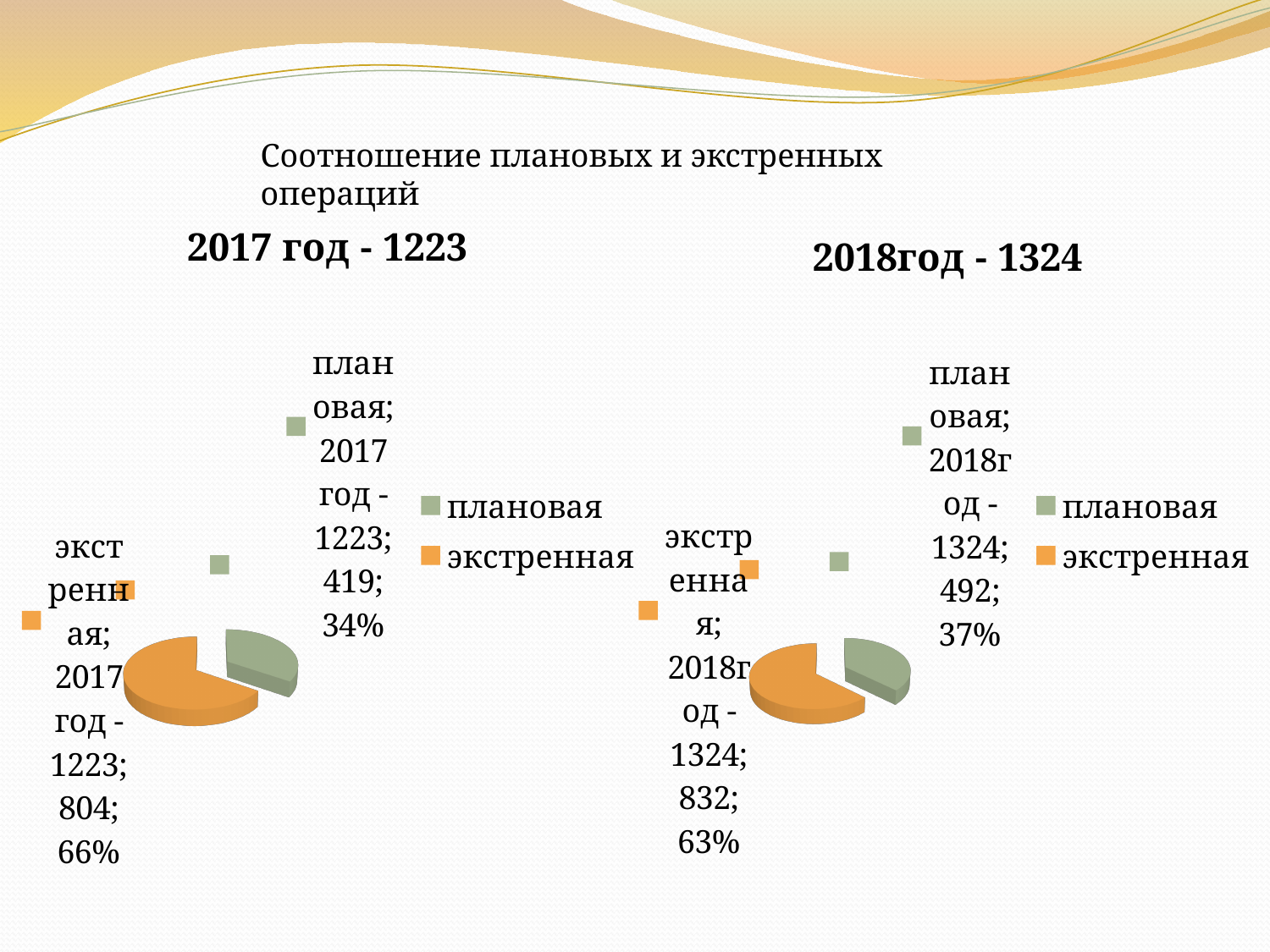
In the "2017 год - 1223" chart, what share of the pie does экстренная take? 66% In the "2017 год - 1223" chart, which category is the largest? экстренная What kind of chart is the "2018год - 1324" chart? pie chart In the "2017 год - 1223" chart, what is the difference between экстренная and плановая? 385 In the "2018год - 1324" chart, what is the value for плановая? 492 In the "2017 год - 1223" chart, what is the value for плановая? 419 How many entries does the legend of the "2017 год - 1223" chart list? 2 In the "2018год - 1324" chart, which category is the smallest? плановая In the "2017 год - 1223" chart, what is the value for экстренная? 804 In the "2018год - 1324" chart, what is the difference between экстренная and плановая? 340 In the "2018год - 1324" chart, what is the value for экстренная? 832 In the "2018год - 1324" chart, what share of the pie does плановая take? 37%